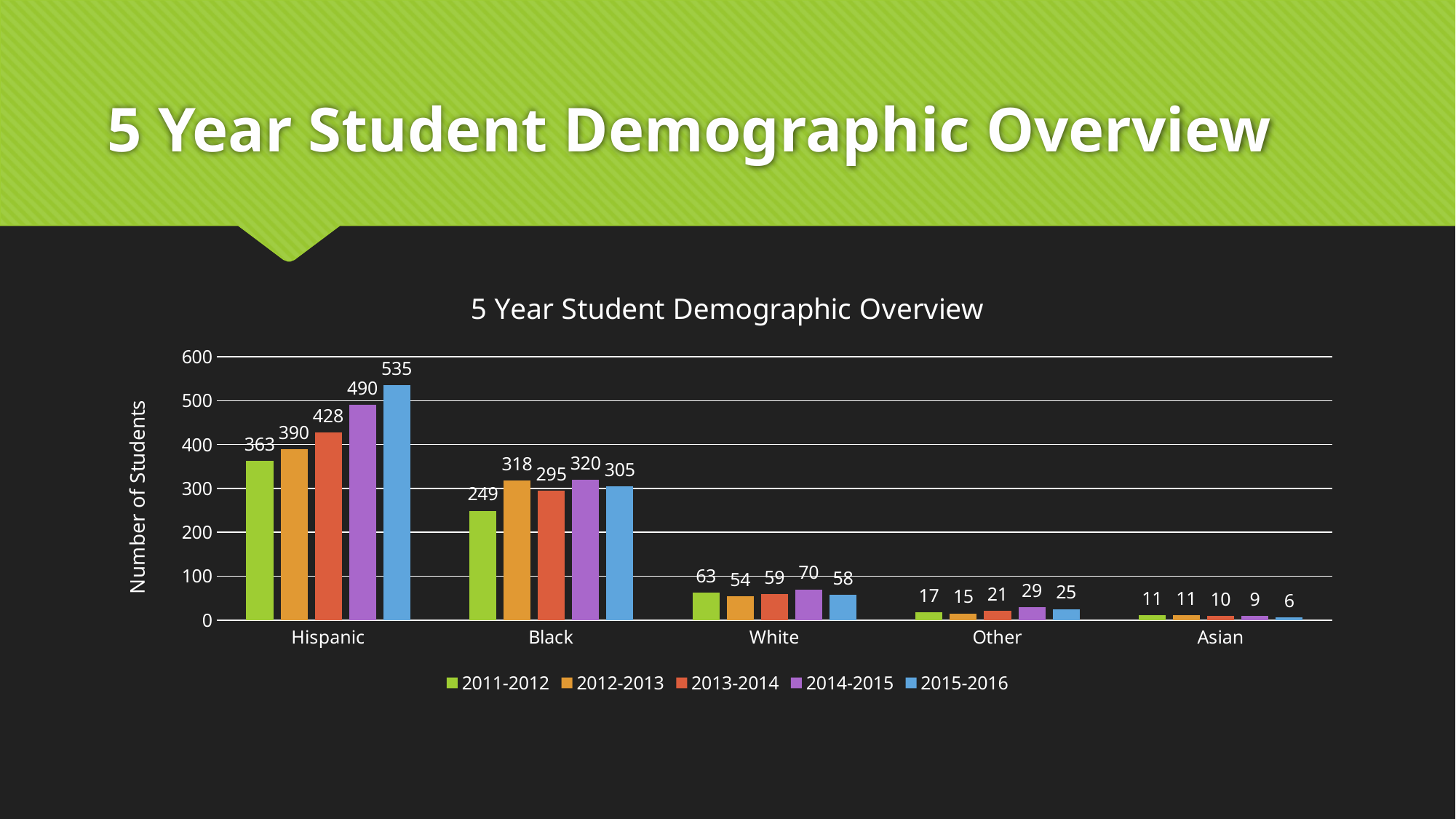
Which category has the lowest value in 2013-2014? Asian What is the number of Black students in 2011-2012? 249 Which category has the highest value in 2015-2016? Hispanic How many series does the legend list? 5 Which is larger: the Black value for 2012-2013 or the Black value for 2015-2016? 2012-2013 What is the label of the vertical axis? Number of Students What kind of chart is shown on the slide? Bar chart What is the number of Hispanic students in 2015-2016? 535 What is the difference between the Hispanic values for 2015-2016 and 2011-2012? 172 What is the number of Asian students in 2015-2016? 6 How many categories are shown on the x axis? 5 What is the number of White students in 2014-2015? 70